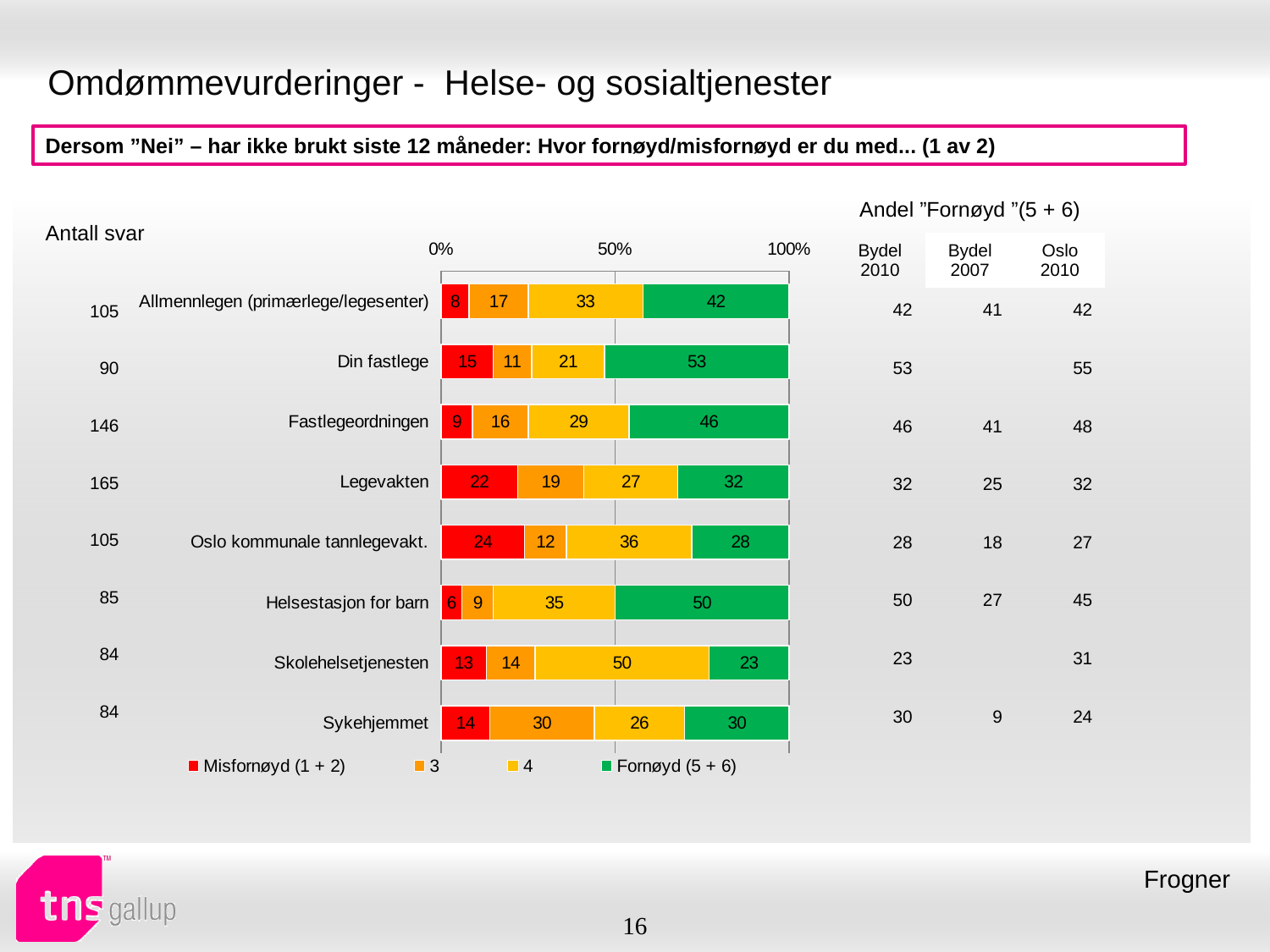
What kind of chart is shown on the slide? Stacked bar chart What is the 'Misfornøyd (1 + 2)' value for Legevakten? 22 What is the difference between the 'Fornøyd (5 + 6)' values for Din fastlege and Legevakten? 21 What colour represents the 'Fornøyd (5 + 6)' series in the chart? Green Which category has the lowest 'Fornøyd (5 + 6)' value? Skolehelsetjenesten Which category has the highest 'Misfornøyd (1 + 2)' value? Oslo kommunale tannlegevakt. How many series does the chart legend list? 4 What is the value of series '4' for Skolehelsetjenesten? 50 Which is larger: the 'Fornøyd (5 + 6)' value for Helsestasjon for barn or for Sykehjemmet? Helsestasjon for barn How many categories (services) are plotted in the chart? 8 What is the 'Fornøyd (5 + 6)' value for Din fastlege? 53 Which category has the highest 'Fornøyd (5 + 6)' value? Din fastlege